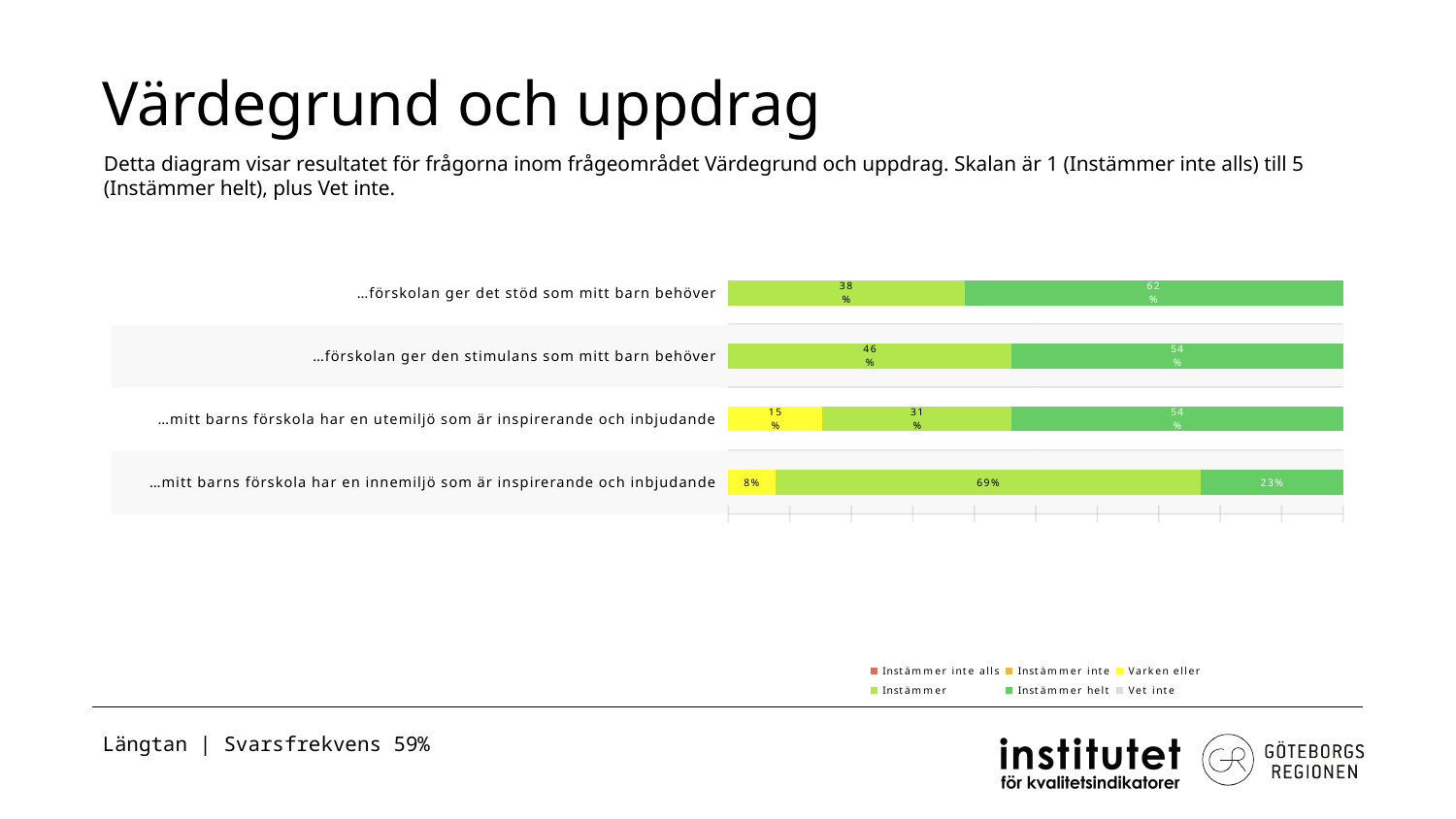
Which statement has the highest 'Instämmer helt' value? …förskolan ger det stöd som mitt barn behöver Which legend entry is shown in yellow? Varken eller How many series does the legend list? 6 How many categories (statements) are plotted in the chart? 4 Which statement has the lowest 'Instämmer helt' value? …mitt barns förskola har en innemiljö som är inspirerande och inbjudande What is the 'Varken eller' value for '…mitt barns förskola har en utemiljö som är inspirerande och inbjudande'? 15% Which is larger: the 'Instämmer' value for '…förskolan ger den stimulans som mitt barn behöver' or the 'Instämmer' value for '…mitt barns förskola har en utemiljö som är inspirerande och inbjudande'? …förskolan ger den stimulans som mitt barn behöver What is the difference between the 'Instämmer helt' values for '…förskolan ger det stöd som mitt barn behöver' and '…mitt barns förskola har en innemiljö som är inspirerande och inbjudande'? 39% What is the 'Instämmer helt' value for '…förskolan ger det stöd som mitt barn behöver'? 62% What is the 'Instämmer' value for '…mitt barns förskola har en innemiljö som är inspirerande och inbjudande'? 69% What is the 'Instämmer' value for '…förskolan ger den stimulans som mitt barn behöver'? 46% What kind of chart is shown on the slide? Stacked bar chart